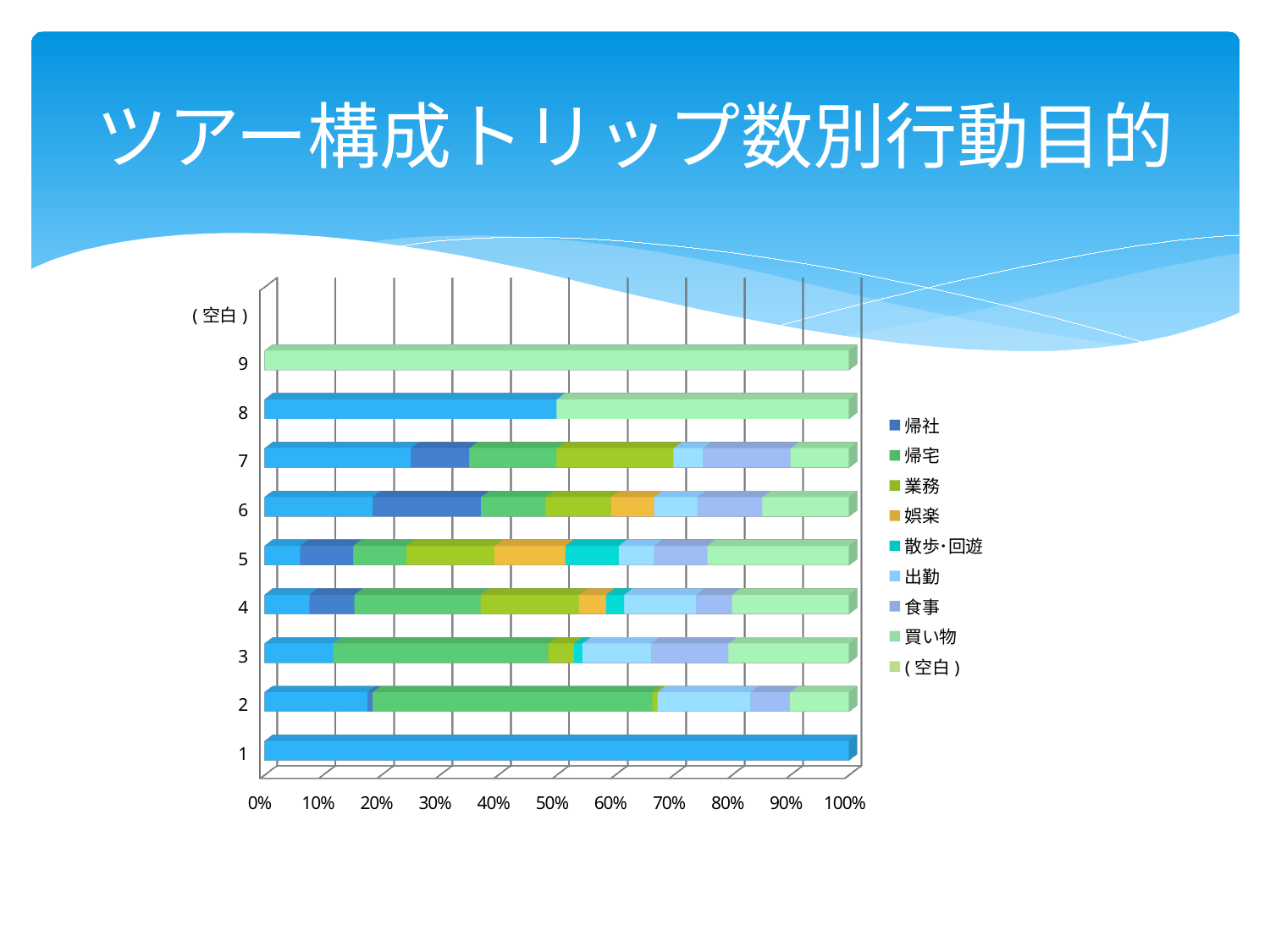
What is the title of the slide? ツアー構成トリップ数別行動目的 What kind of chart is shown on the slide? Stacked bar chart Is the 買い物 share for category 8 greater or less than 40%? greater Is the 散歩・回遊 share for category 5 greater or less than 20%? less Which has the larger 帰宅 share, category 2 or category 7? Category 2 How many series does the legend list? 9 Is the 帰宅 share for category 2 greater or less than 40%? greater What is the highest value shown on the horizontal axis? 100% How many category labels are shown on the vertical axis? 10 Which category has the largest 買い物 share? 9